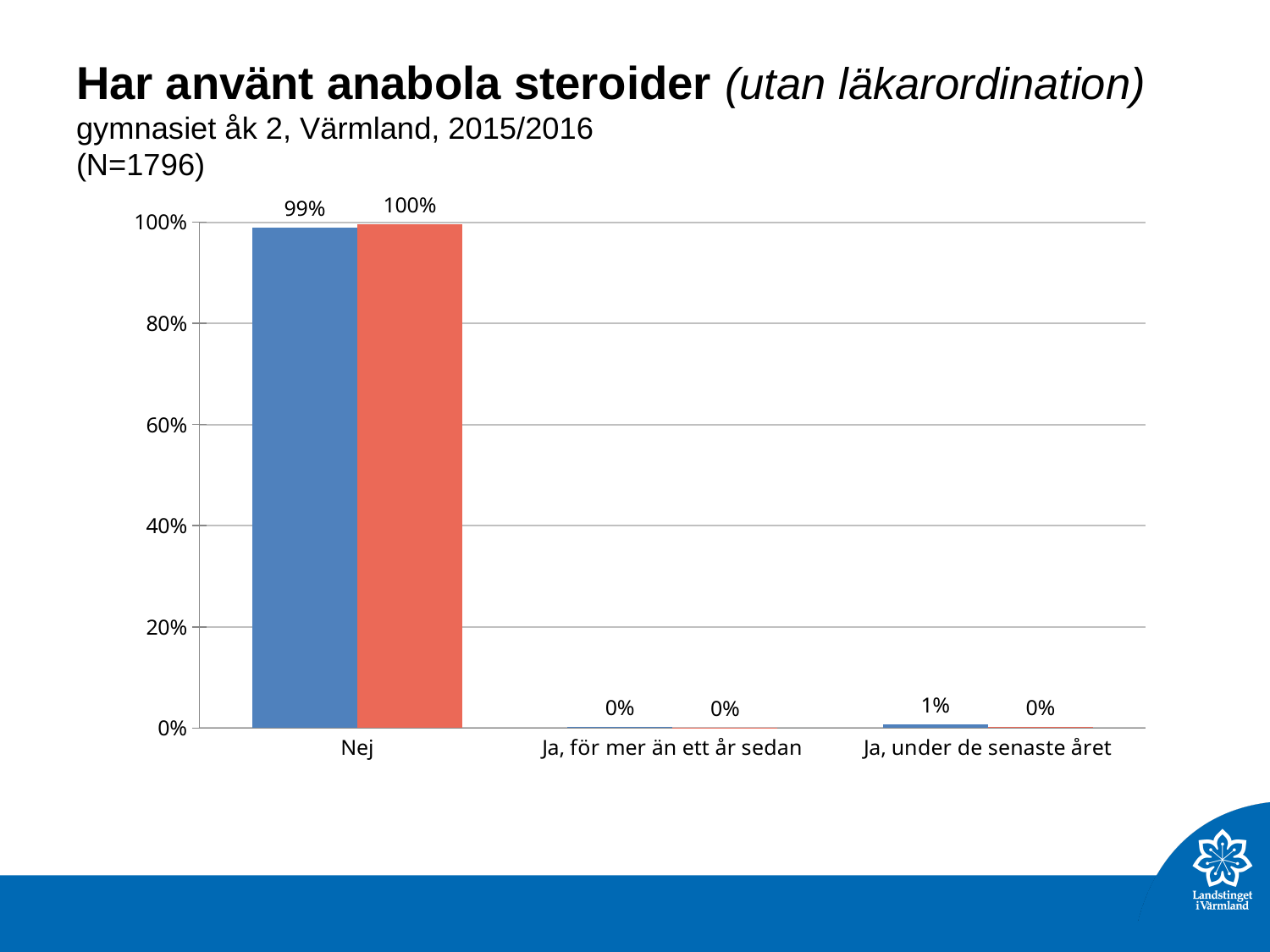
Is the value of the blue bar for "Nej" greater or less than 80%? greater What is the value of the orange bar for "Nej"? 100% What is the difference between the orange bar and the blue bar for "Nej"? 1% What kind of chart is shown on the slide? bar chart How many categories are shown on the x axis? 3 What is the value of the orange bar for "Ja, under de senaste året"? 0% Which category has the highest values? Nej What is the sample size (N) stated in the chart title? 1796 What is the value of the blue bar for "Ja, under de senaste året"? 1% What is the value of the blue bar for "Ja, för mer än ett år sedan"? 0% For "Nej", which bar is larger, the blue one or the orange one? the orange one What is the value of the blue bar for "Nej"? 99%